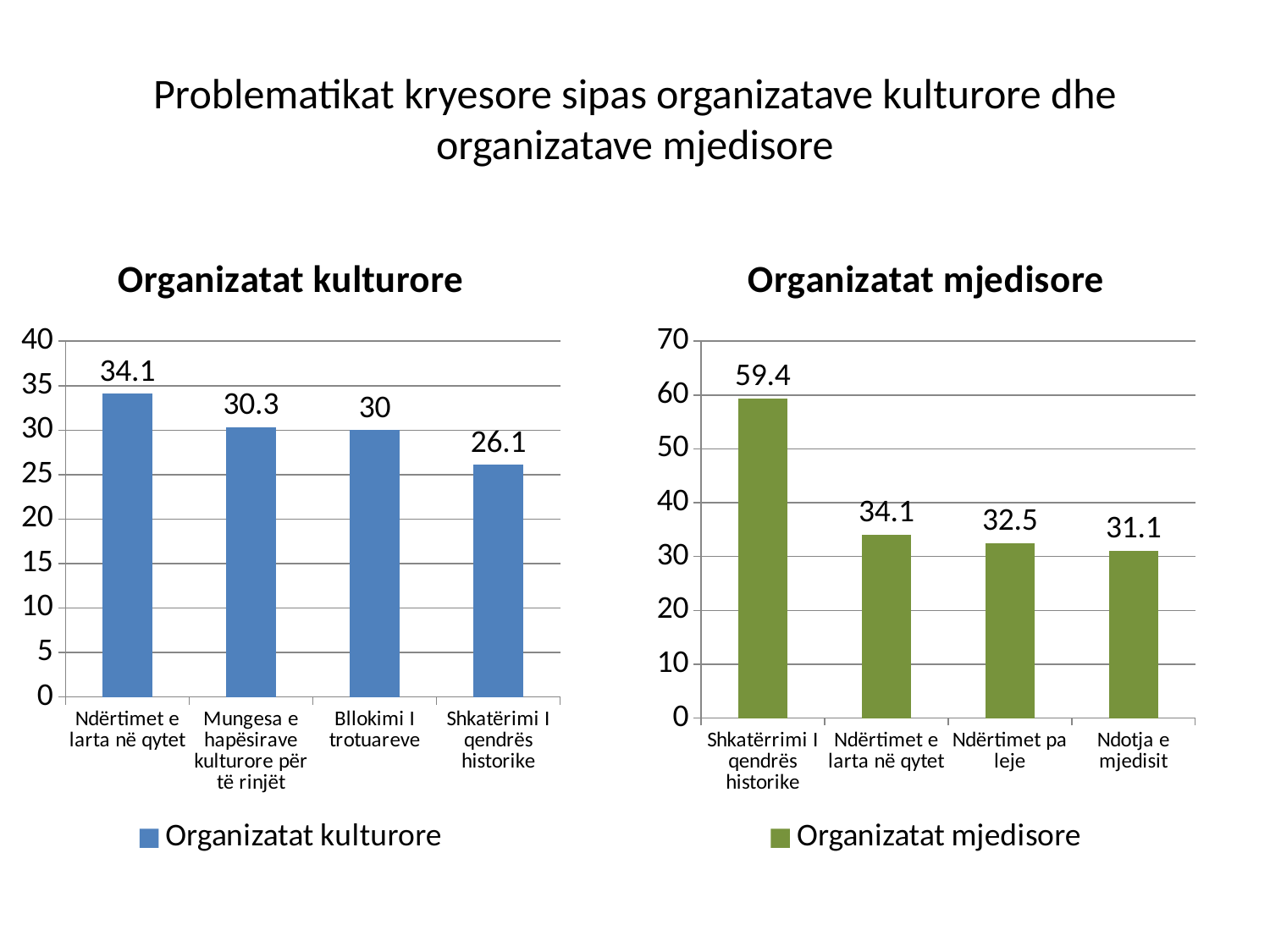
In the 'Organizatat kulturore' chart, what is the value for 'Bllokimi I trotuareve'? 30 In the 'Organizatat mjedisore' chart, what is the value for 'Ndotja e mjedisit'? 31.1 What type of chart is the 'Organizatat mjedisore' chart? Bar chart In the 'Organizatat kulturore' chart, how many categories are shown? 4 In the 'Organizatat mjedisore' chart, which is larger: 'Ndërtimet pa leje' or 'Ndotja e mjedisit'? Ndërtimet pa leje In the 'Organizatat kulturore' chart, do the values rise or fall from left to right? Fall In the 'Organizatat mjedisore' chart, what is the value for 'Shkatërrimi I qendrës historike'? 59.4 In the 'Organizatat kulturore' chart, what is the difference between 'Ndërtimet e larta në qytet' and 'Shkatërimi I qendrës historike'? 8 In the 'Organizatat kulturore' chart, what is the value for 'Ndërtimet e larta në qytet'? 34.1 In the 'Organizatat mjedisore' chart, which category has the highest value? Shkatërrimi I qendrës historike In the 'Organizatat mjedisore' chart, what is the difference between 'Shkatërrimi I qendrës historike' and 'Ndërtimet e larta në qytet'? 25.3 In the 'Organizatat kulturore' chart, which category has the lowest value? Shkatërimi I qendrës historike